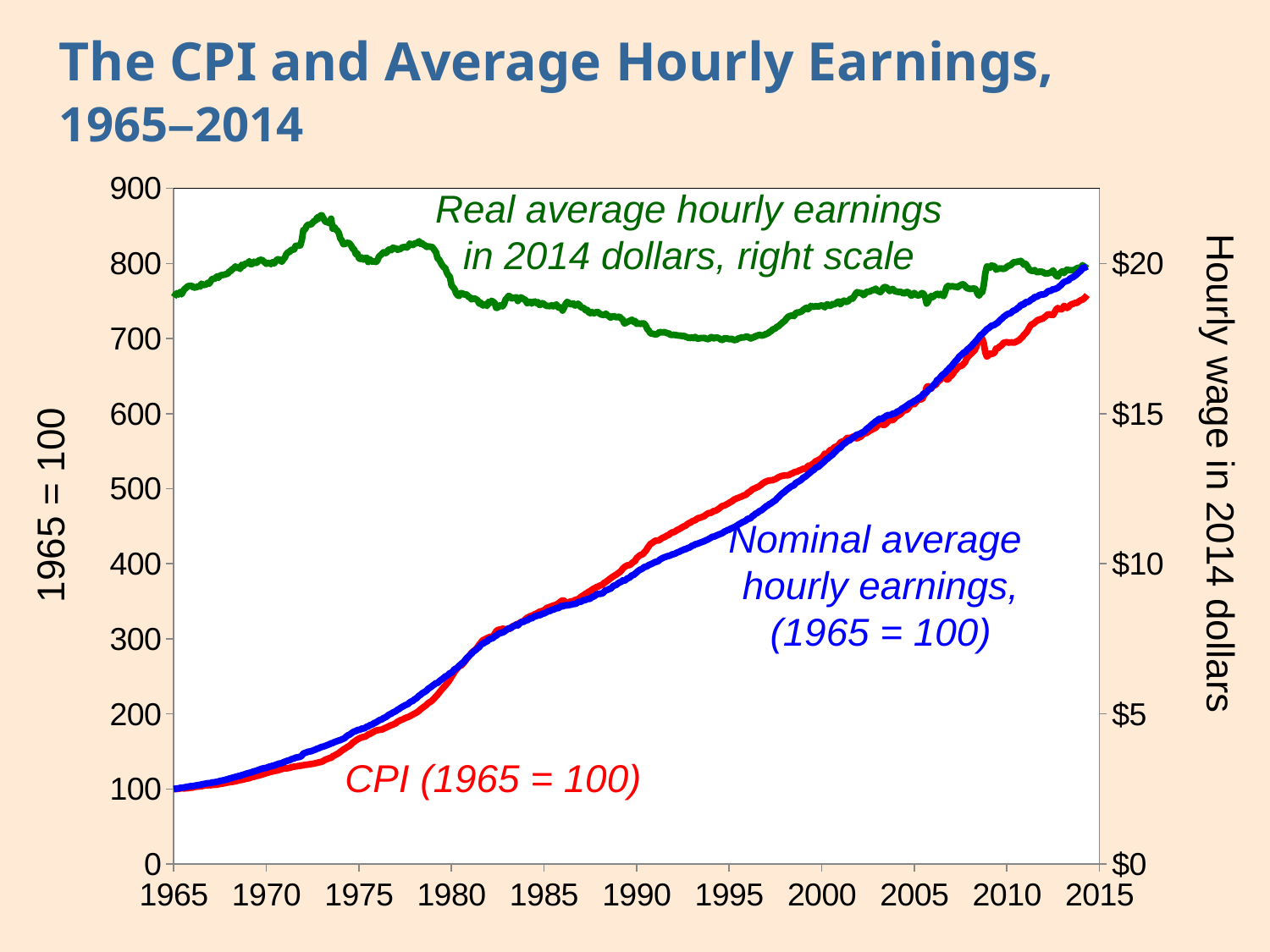
Does the CPI (1965 = 100) series rise or fall from 1965 to 2014? rise Is the value of the CPI (1965 = 100) series in 2014 greater or less than 700? greater Is the value of the Real average hourly earnings series in 1995 greater or less than $15? greater What is the value of the CPI (1965 = 100) series in 1965? 100 In 1995, which is higher: the CPI (1965 = 100) series or the Nominal average hourly earnings (1965 = 100) series? CPI (1965 = 100) What is the title of the chart on the slide? The CPI and Average Hourly Earnings, 1965–2014 Is the value of the Nominal average hourly earnings (1965 = 100) series in 2014 greater or less than 700? greater In 2014, which is higher: the CPI (1965 = 100) series or the Nominal average hourly earnings (1965 = 100) series? Nominal average hourly earnings (1965 = 100) Does the Nominal average hourly earnings (1965 = 100) series rise or fall from 1965 to 2014? rise What kind of chart is shown on the slide? line chart How many data series are plotted on the chart? 3 Which series is plotted against the right scale? Real average hourly earnings in 2014 dollars